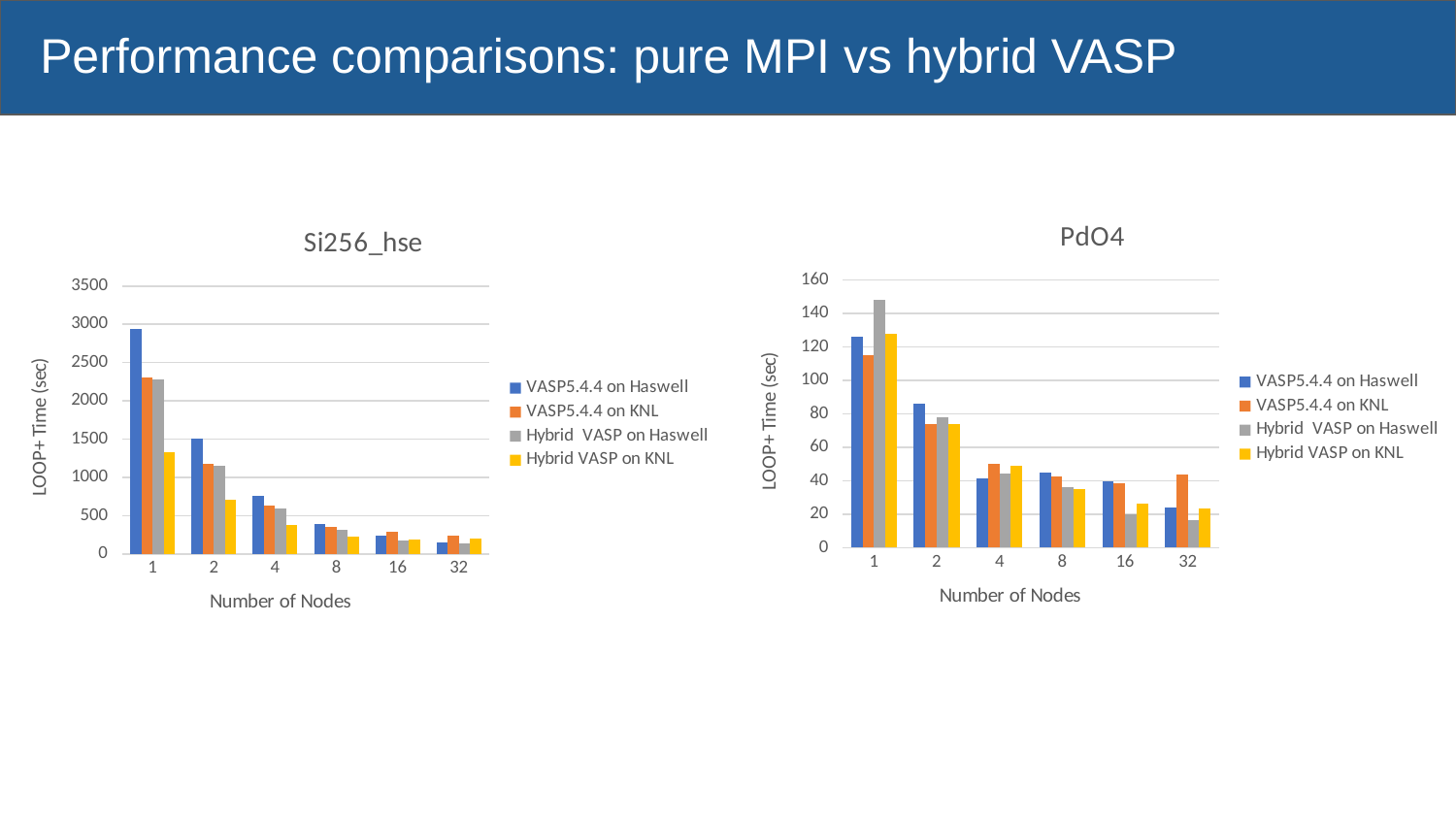
In the PdO4 chart, which series has the highest value at 32 nodes? VASP5.4.4 on KNL What type of chart is the Si256_hse chart? bar chart How many series does the legend of the PdO4 chart list? 4 In the Si256_hse chart, is the value for VASP5.4.4 on Haswell at 1 node greater or less than 2500? greater In the Si256_hse chart, which series has the highest value at 1 node? VASP5.4.4 on Haswell In the PdO4 chart, which series has the highest value at 1 node? Hybrid VASP on Haswell In the Si256_hse chart, which series has the lowest value at 1 node? Hybrid VASP on KNL In the PdO4 chart, which is larger at 1 node: VASP5.4.4 on Haswell or VASP5.4.4 on KNL? VASP5.4.4 on Haswell In the Si256_hse chart, is the value for Hybrid VASP on KNL at 1 node greater or less than 1500? less In the PdO4 chart, does the value for VASP5.4.4 on Haswell rise or fall as the number of nodes increases? fall How many node counts are shown on the x axis of the Si256_hse chart? 6 In the PdO4 chart, is the value for Hybrid VASP on Haswell at 1 node greater or less than 140? greater